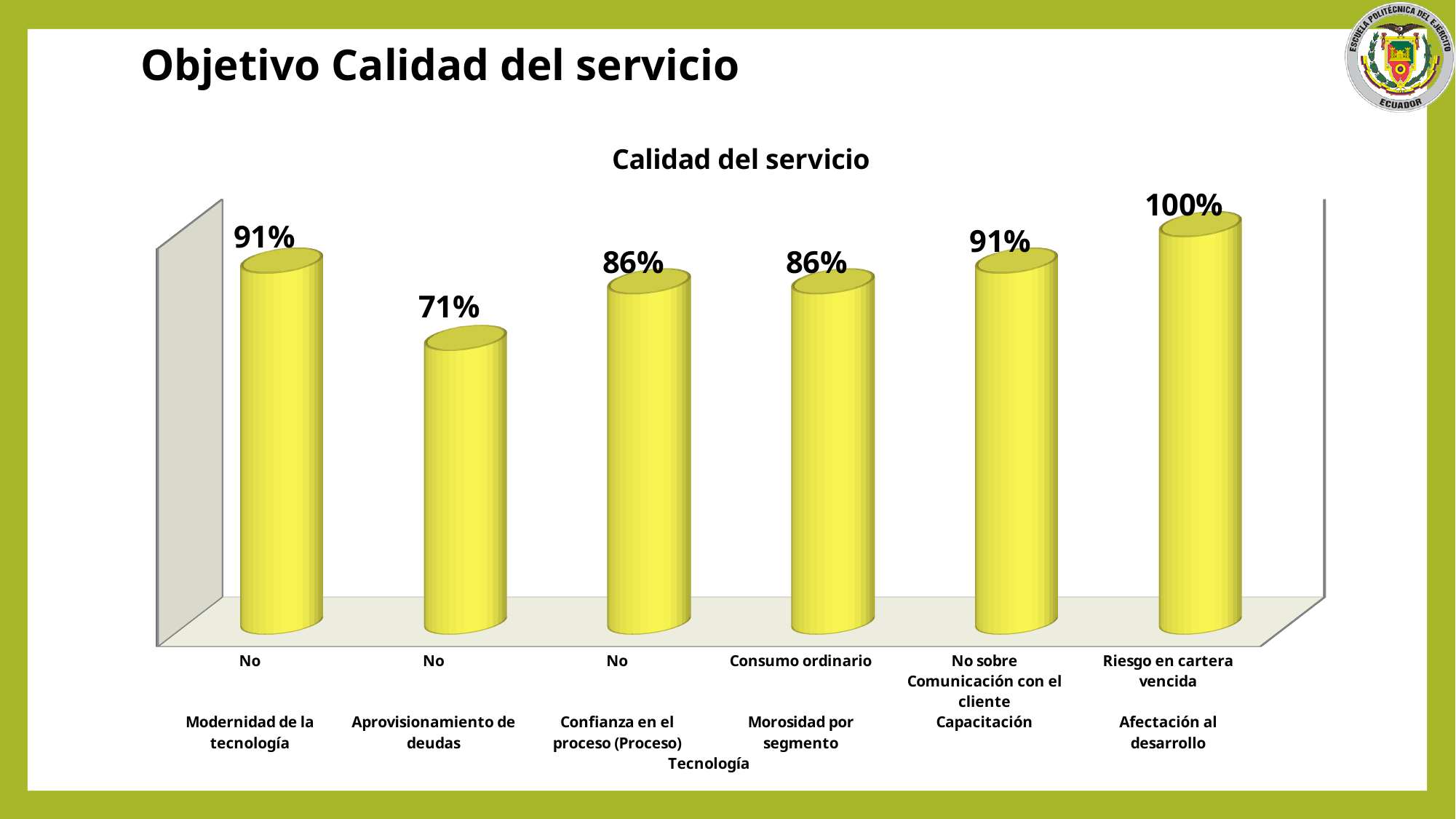
What kind of chart is shown on the slide? Bar chart Which is larger, the value for Capacitación or the value for Morosidad por segmento? Capacitación Which category has the lowest value? Aprovisionamiento de deudas What is the title of the chart? Calidad del servicio What is the value for Afectación al desarrollo? 100% What is the difference between the values for Modernidad de la tecnología and Confianza en el proceso (Proceso)? 5% What is the value for Aprovisionamiento de deudas? 71% What is the difference between the values for Afectación al desarrollo and Aprovisionamiento de deudas? 29% How many bars are shown in the chart? 6 What is the value for Confianza en el proceso (Proceso)? 86% What is the value for Modernidad de la tecnología? 91% Which category has the highest value? Afectación al desarrollo